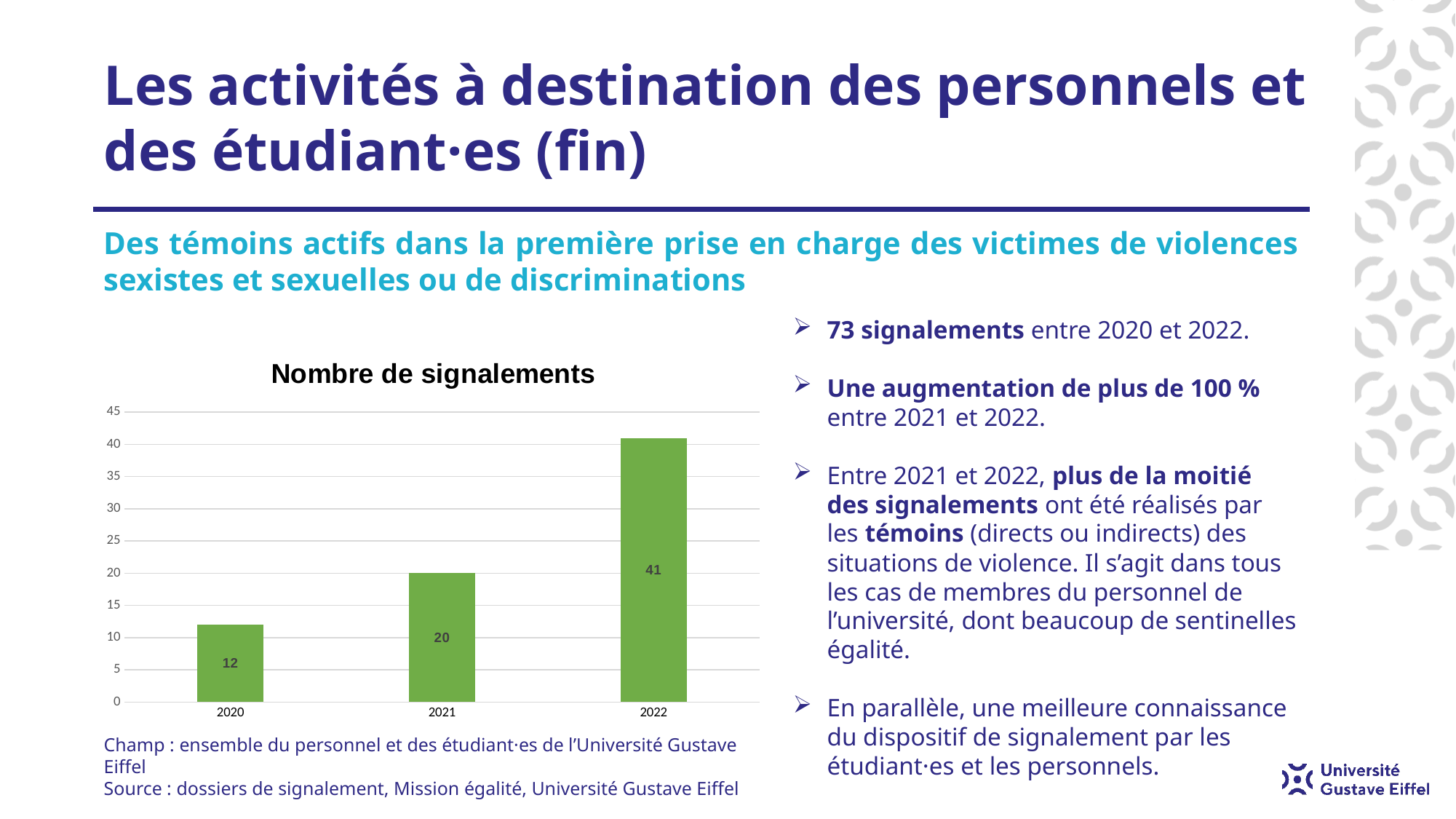
Is the value for 2022 greater or less than 35? greater Which year has the lowest number of signalements? 2020 What is the difference in signalements between 2021 and 2020? 8 How many years are shown on the x axis of the chart? 3 What is the number of signalements for 2022? 41 What is the difference in signalements between 2022 and 2021? 21 What is the number of signalements for 2020? 12 Which year has more signalements, 2020 or 2021? 2021 Do the values rise or fall from 2020 to 2022? rise Which year has the highest number of signalements? 2022 What is the number of signalements for 2021? 20 What kind of chart is used to show the number of signalements? bar chart